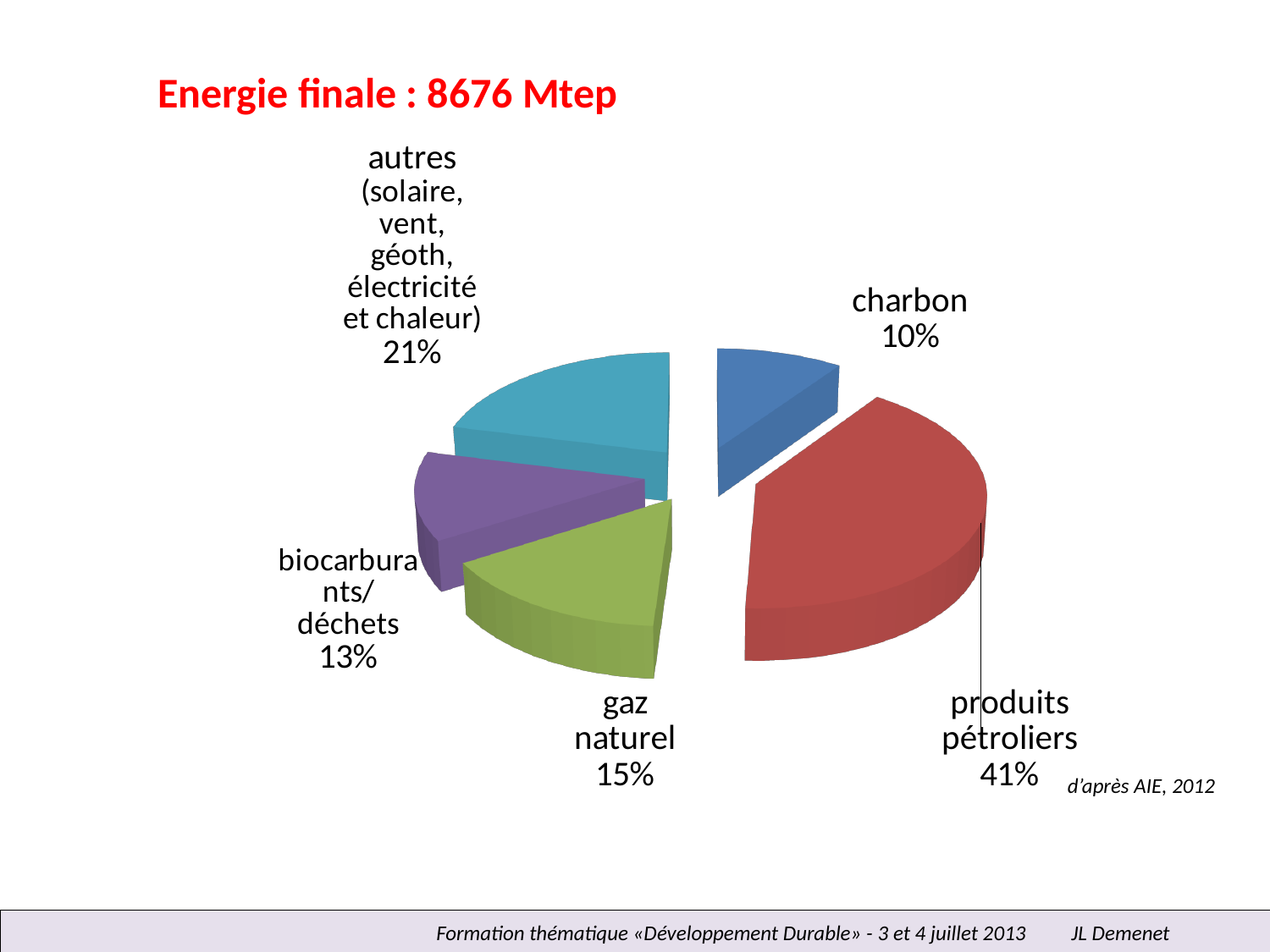
Which category has the smallest slice of the pie? charbon How many slices does the pie chart have? 5 Which is larger, the share for 'autres' or the share for 'biocarburants/déchets'? autres What share of the pie does 'produits pétroliers' represent? 41% What share of the pie does the 'autres' slice represent? 21% What is the title shown above the pie chart? Energie finale : 8676 Mtep What kind of chart is shown on the slide? pie chart What is the difference in percentage points between 'produits pétroliers' and 'gaz naturel'? 26 What share of the pie does 'gaz naturel' represent? 15% Which category has the largest slice of the pie? produits pétroliers